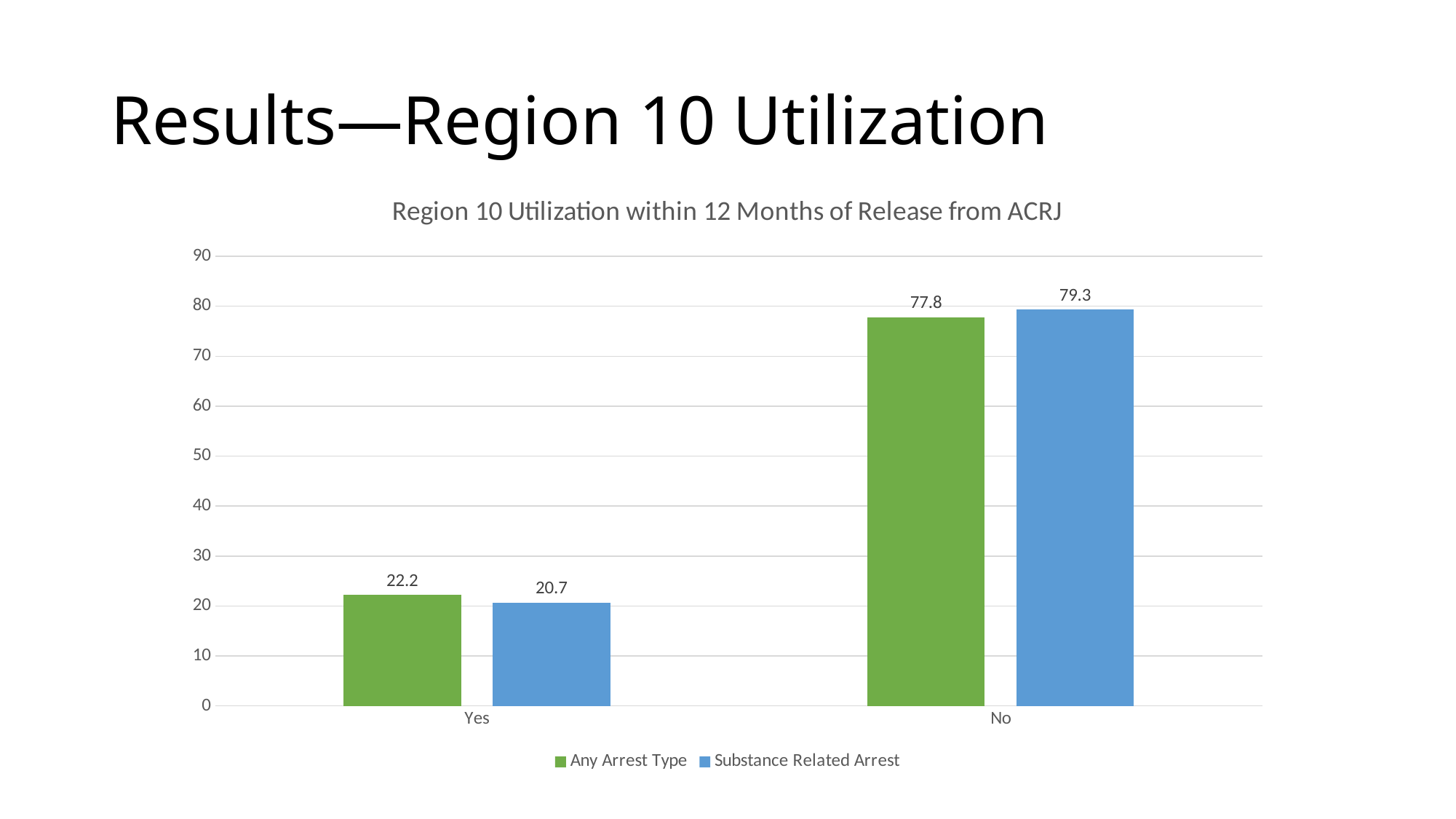
What is the value for Any Arrest Type in the Yes category? 22.2 What kind of chart is shown on the slide? Bar chart What is the value for Substance Related Arrest in the No category? 79.3 What is the value for Substance Related Arrest in the Yes category? 20.7 What is the value for Any Arrest Type in the No category? 77.8 What is the difference between the Any Arrest Type values for No and Yes? 55.6 Which category has the lowest value for Substance Related Arrest? Yes How many categories are shown on the x axis? 2 Which category has the highest value for Any Arrest Type? No Which is larger in the Yes category: Any Arrest Type or Substance Related Arrest? Any Arrest Type How many series does the legend list? 2 Is the value for Substance Related Arrest in the No category greater or less than 70? greater